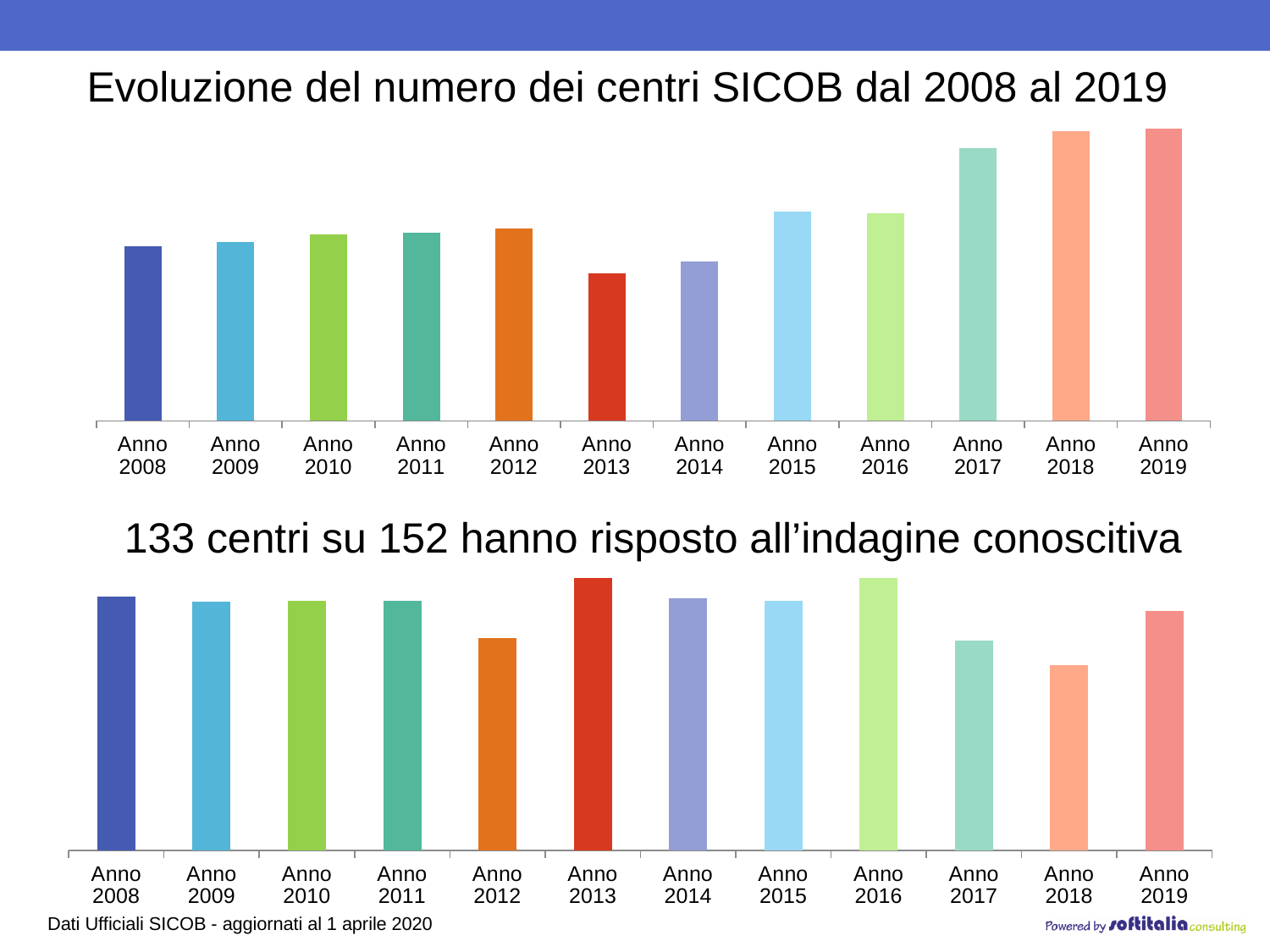
What kind of chart is the bottom chart titled '133 centri su 152 hanno risposto all'indagine conoscitiva'? Bar chart In the bottom chart '133 centri su 152 hanno risposto all'indagine conoscitiva', which bar is taller: Anno 2017 or Anno 2019? Anno 2019 How many bars are shown on the bottom chart '133 centri su 152 hanno risposto all'indagine conoscitiva'? 12 What kind of chart is the top chart titled 'Evoluzione del numero dei centri SICOB dal 2008 al 2019'? Bar chart In the bottom chart '133 centri su 152 hanno risposto all'indagine conoscitiva', which bar is taller: Anno 2012 or Anno 2013? Anno 2013 In the top chart 'Evoluzione del numero dei centri SICOB dal 2008 al 2019', do the values rise or fall from Anno 2014 to Anno 2019? Rise How many years (categories) are shown on the top chart 'Evoluzione del numero dei centri SICOB dal 2008 al 2019'? 12 In the bottom chart '133 centri su 152 hanno risposto all'indagine conoscitiva', which year has the lowest bar? Anno 2018 In the top chart 'Evoluzione del numero dei centri SICOB dal 2008 al 2019', which bar is taller: Anno 2017 or Anno 2018? Anno 2018 In the top chart 'Evoluzione del numero dei centri SICOB dal 2008 al 2019', which year has the lowest bar? Anno 2013 What is the title of the top chart on the slide? Evoluzione del numero dei centri SICOB dal 2008 al 2019